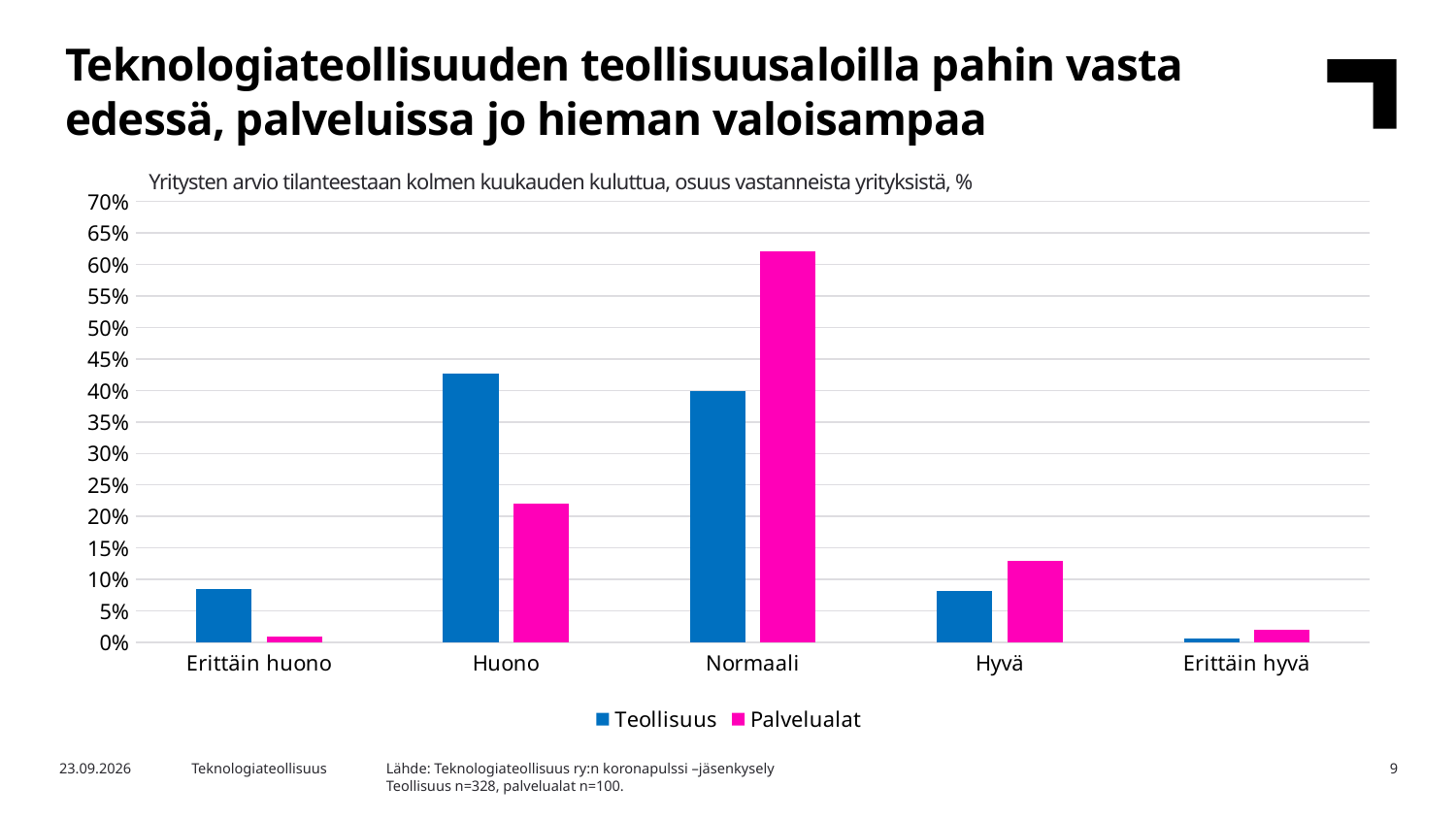
For the category Huono, which series has the larger value, Teollisuus or Palvelualat? Teollisuus Which category has the highest value for Teollisuus? Huono How many series does the legend list? 2 For the category Normaali, which series has the larger value, Teollisuus or Palvelualat? Palvelualat How many categories are shown on the x axis? 5 Is the value for Palvelualat in the category Normaali greater or less than 60%? greater Is the value for Teollisuus in the category Huono greater or less than 45%? less What kind of chart is shown on the slide? Bar chart What are the two series named in the legend? Teollisuus and Palvelualat Which category has the highest value for Palvelualat? Normaali Which category has the lowest value for Teollisuus? Erittäin hyvä Which category has the lowest value for Palvelualat? Erittäin huono